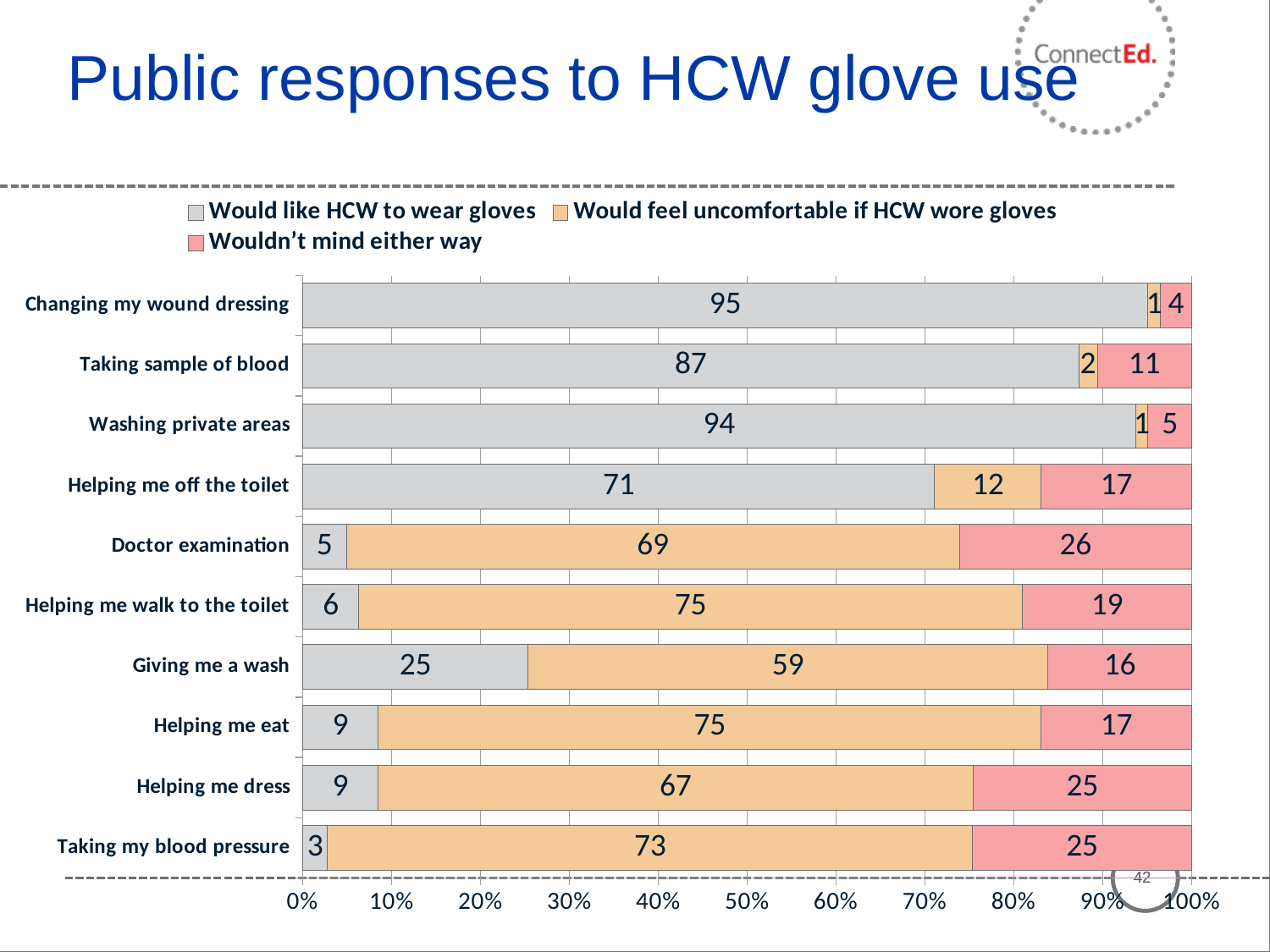
What percentage of respondents would like HCW to wear gloves when changing their wound dressing? 95 What is the difference between the 'Would feel uncomfortable if HCW wore gloves' values for 'Helping me eat' and 'Giving me a wash'? 16 What is the value for 'Wouldn't mind either way' for 'Doctor examination'? 26 How many series does the legend list? 3 What kind of chart is shown on the slide? Stacked bar chart Which category has the highest value for 'Would like HCW to wear gloves'? Changing my wound dressing Which is larger: the 'Wouldn't mind either way' value for 'Taking sample of blood' or for 'Helping me dress'? Helping me dress What is the total of the stacked bar for 'Helping me off the toilet'? 100 What colour represents 'Wouldn't mind either way' in the chart? Pink Which category has the lowest value for 'Would like HCW to wear gloves'? Taking my blood pressure What is the value for 'Would feel uncomfortable if HCW wore gloves' for 'Helping me off the toilet'? 12 How many categories are shown on the chart? 10